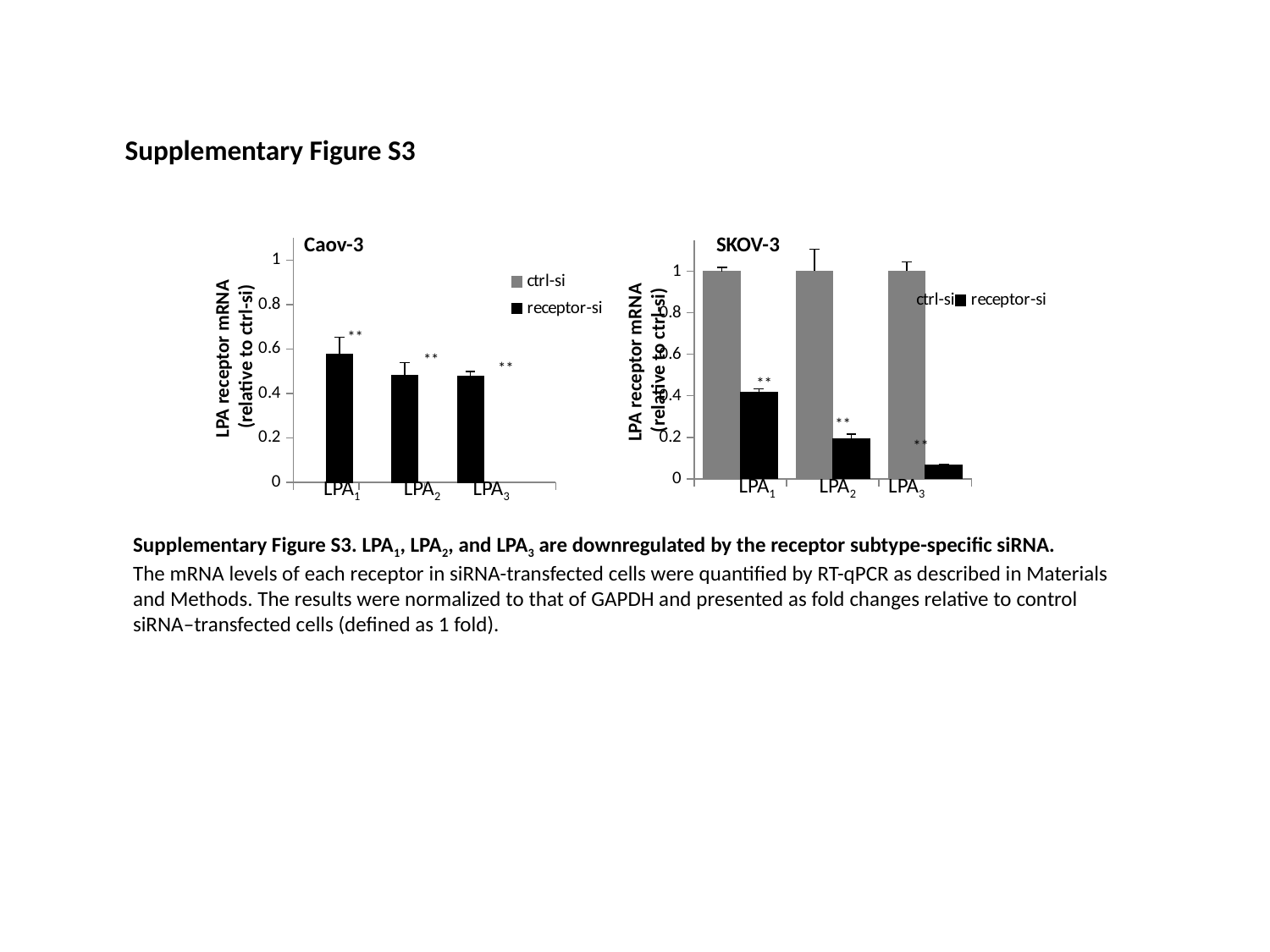
What is the y-axis label of the Caov-3 chart? LPA receptor mRNA (relative to ctrl-si) What kind of chart is the Caov-3 chart? bar chart In the SKOV-3 chart, which is larger, the receptor-si value for LPA1 or for LPA2? LPA1 In the Caov-3 chart, is the receptor-si value for LPA2 greater or less than 0.6? less In the SKOV-3 chart, is the receptor-si value for LPA3 greater or less than 0.2? less How many series does the legend of the Caov-3 chart list? 2 In the SKOV-3 chart, is the receptor-si value for LPA2 greater or less than 0.4? less In the SKOV-3 chart, what is the ctrl-si value for LPA1? 1 In the SKOV-3 chart, which category has the lowest receptor-si value? LPA3 How many categories are shown on the x axis of the SKOV-3 chart? 3 In the SKOV-3 chart, which category has the highest receptor-si value? LPA1